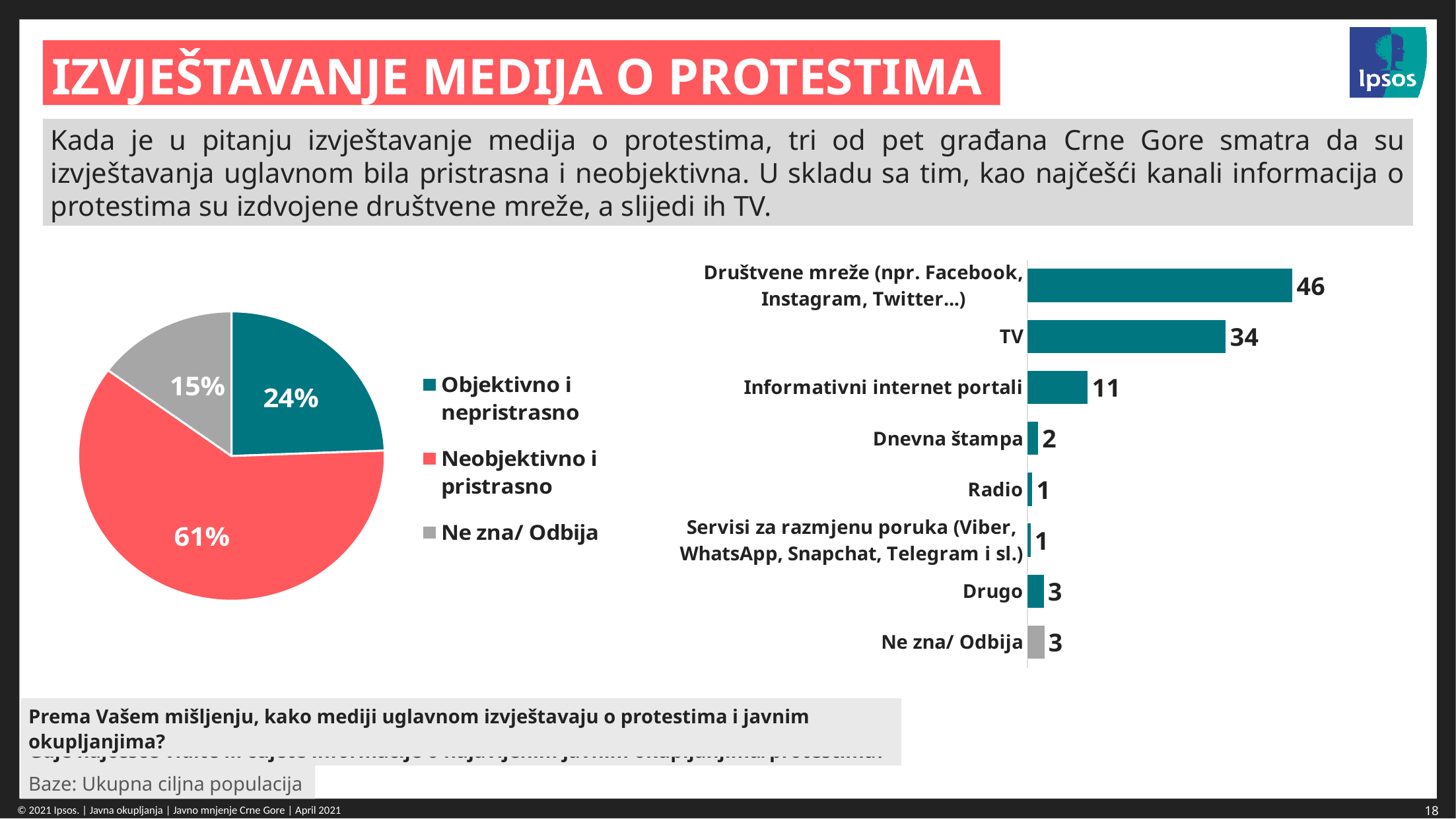
In the bar chart on the right, what is the value for Informativni internet portali? 11 In the pie chart on the left, how many categories does the legend list? 3 In the bar chart on the right, which category has the highest value? Društvene mreže (npr. Facebook, Instagram, Twitter…) In the pie chart on the left, which category has the smallest slice? Ne zna/ Odbija In the bar chart on the right, what is the value for TV? 34 In the bar chart on the right, how many categories are shown? 8 In the pie chart on the left, what share of respondents answered "Neobjektivno i pristrasno"? 61% In the pie chart on the left, what share of respondents answered "Objektivno i nepristrasno"? 24% In the bar chart on the right, which is larger: the value for Dnevna štampa or the value for Drugo? Drugo In the bar chart on the right, what is the difference between the values for Društvene mreže and TV? 12 In the pie chart on the left, what is the difference between the "Neobjektivno i pristrasno" and "Objektivno i nepristrasno" shares? 37% What type of chart is shown on the right side of the slide? Bar chart